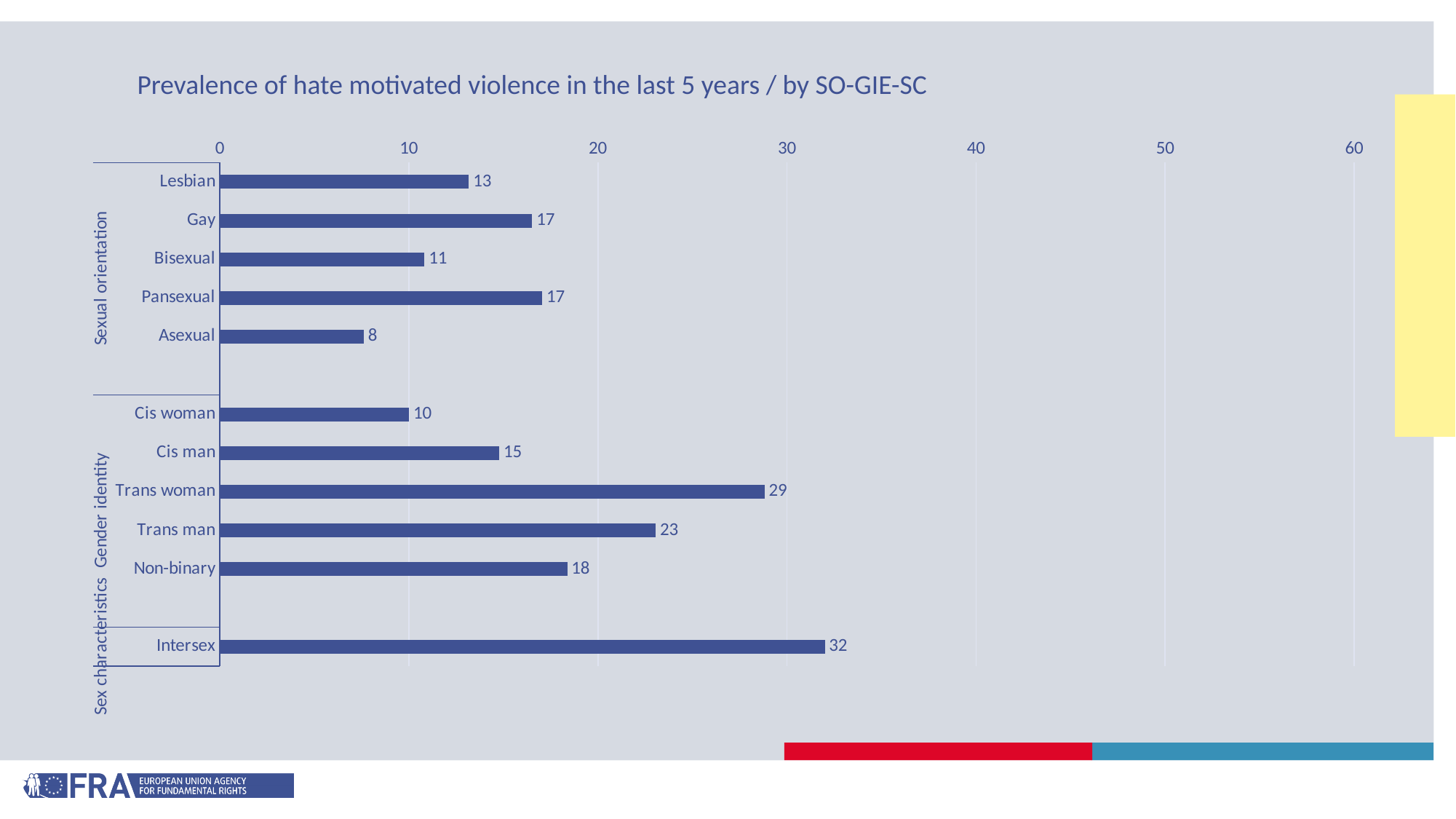
What is the value for Trans woman? 29 What is the value for Asexual? 8 What kind of chart is shown on the slide? bar chart Which category has the highest value? Intersex What is the difference between the values for Intersex and Trans woman? 3 What is the title of the chart? Prevalence of hate motivated violence in the last 5 years / by SO-GIE-SC Which is larger, the value for Trans man or the value for Non-binary? Trans man Is the value for Intersex greater or less than 30? greater What is the difference between the values for Gay and Lesbian? 4 Which category has the lowest value? Asexual What is the value for Cis man? 15 How many categories are plotted in the chart? 11